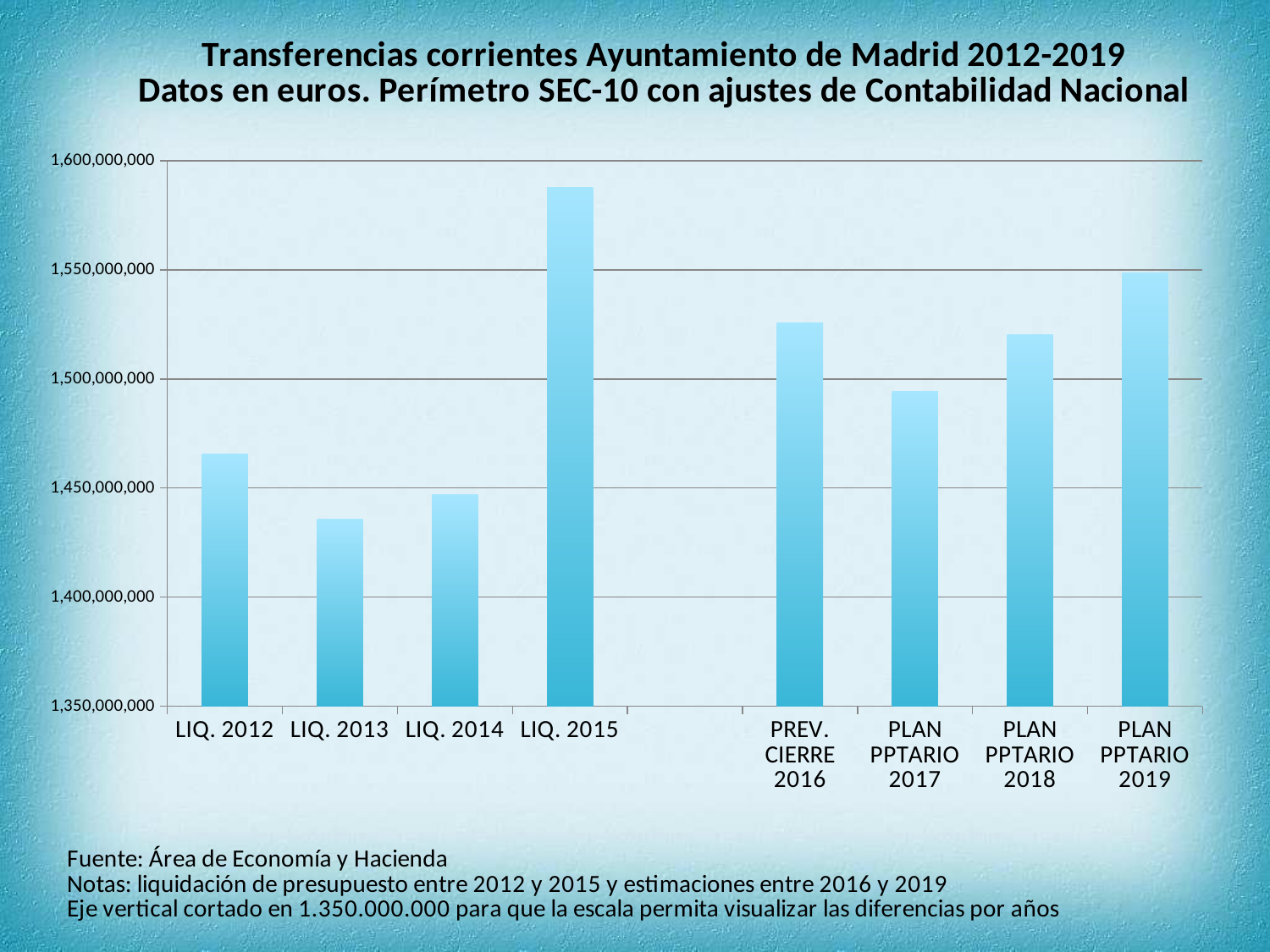
How many bars (categories) are plotted in the chart? 8 Is the value for LIQ. 2013 greater or less than 1,450,000,000? less What kind of chart is shown on the slide? bar chart Which is larger, the value for LIQ. 2012 or the value for LIQ. 2014? LIQ. 2012 Which category has the lowest value in the chart? LIQ. 2013 Which is larger, the value for PLAN PPTARIO 2019 or the value for PLAN PPTARIO 2018? PLAN PPTARIO 2019 Which category has the highest value in the chart? LIQ. 2015 Is the value for LIQ. 2015 greater or less than 1,550,000,000? greater Is the value for PLAN PPTARIO 2017 greater or less than 1,500,000,000? less According to the title, what period does the chart cover? 2012-2019 At what value does the vertical axis of the chart start? 1,350,000,000